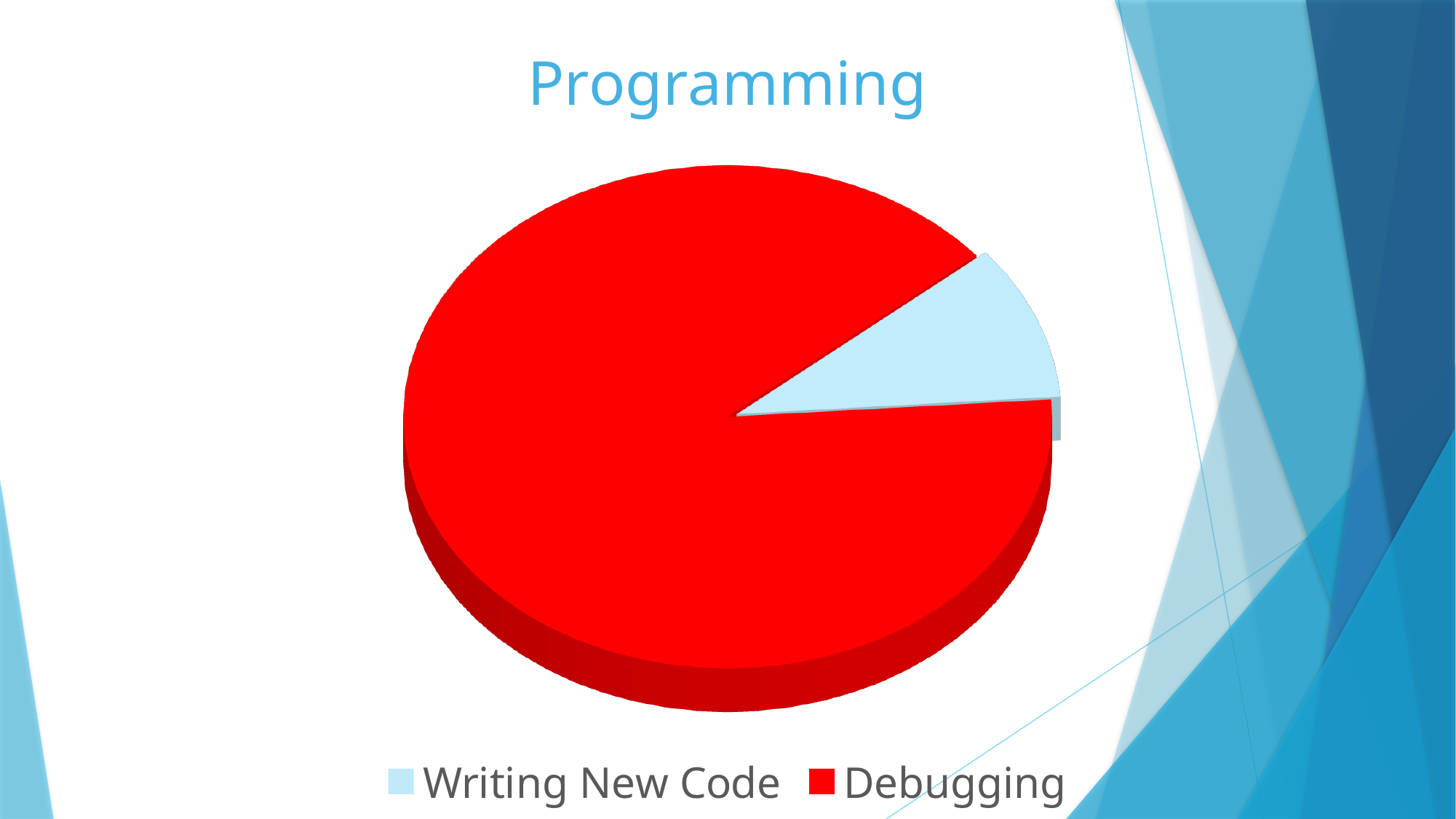
How many slices does the pie chart have? 2 Which slice is the largest in the pie chart? Debugging Which slice is the smallest in the pie chart? Writing New Code What colour is the Debugging slice? red What kind of chart is shown on the slide? pie chart Which is larger, the Debugging slice or the Writing New Code slice? Debugging Which legend entry is shown in light blue? Writing New Code How many entries does the legend list? 2 What is the title of the chart? Programming